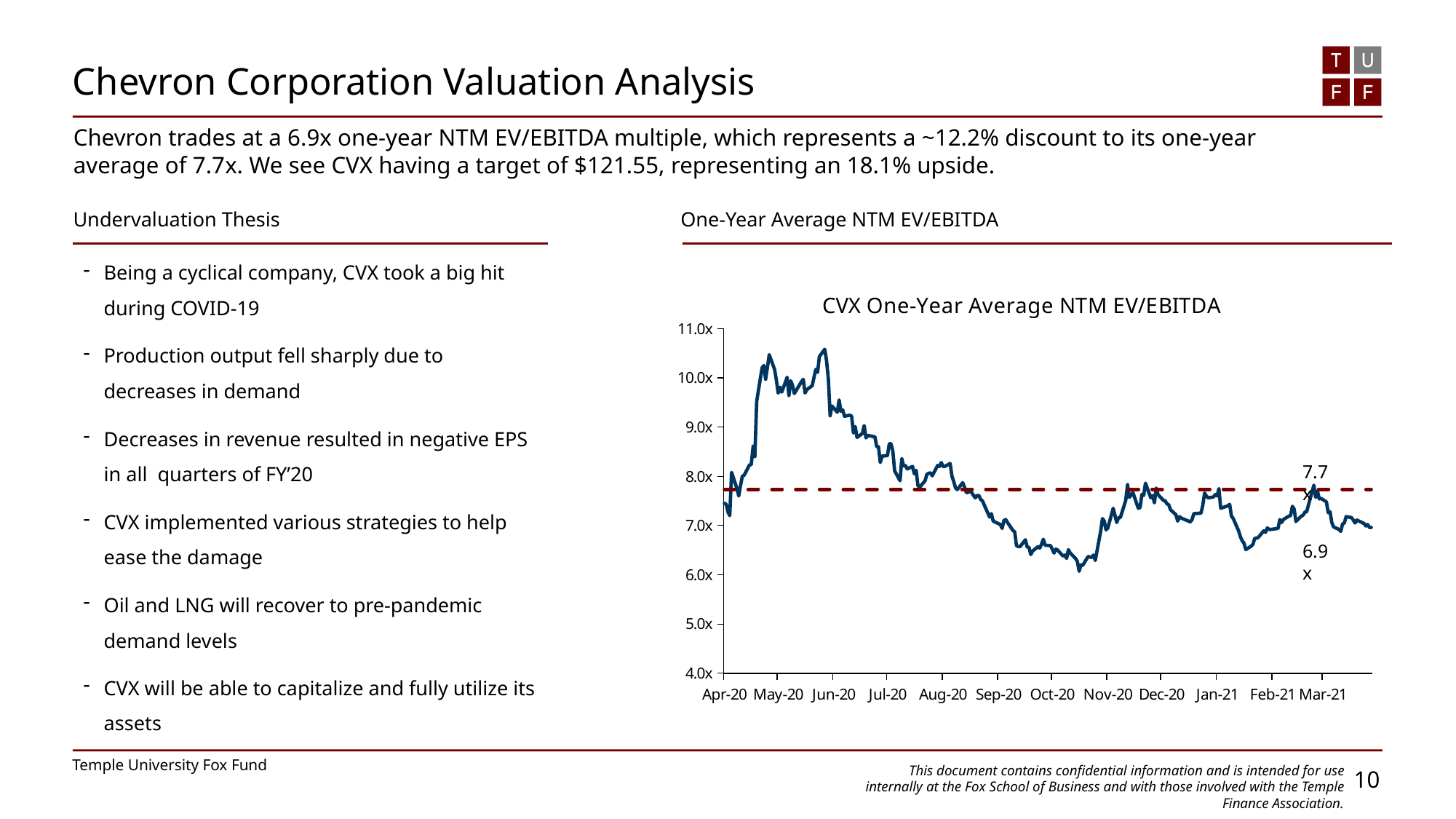
How many month labels are shown on the x axis of the chart? 12 What kind of chart is shown on the slide? line chart What is the difference between the one-year average of 7.7x and the current value of 6.9x shown on the chart? 0.8x What is the most recent NTM EV/EBITDA value labelled at the end of the line in the chart? 6.9x Does the line rise or fall between Jun-20 and Oct-20? fall Is the value at Oct-20 greater or less than 7.0x? less Is the value at Apr-20 greater or less than 9.0x? less Is the value at May-20 higher or lower than the value at Oct-20? higher What value is labelled on the dashed horizontal average line in the chart? 7.7x Is the value at Sep-20 greater or less than 8.0x? less What is the title of the chart? CVX One-Year Average NTM EV/EBITDA